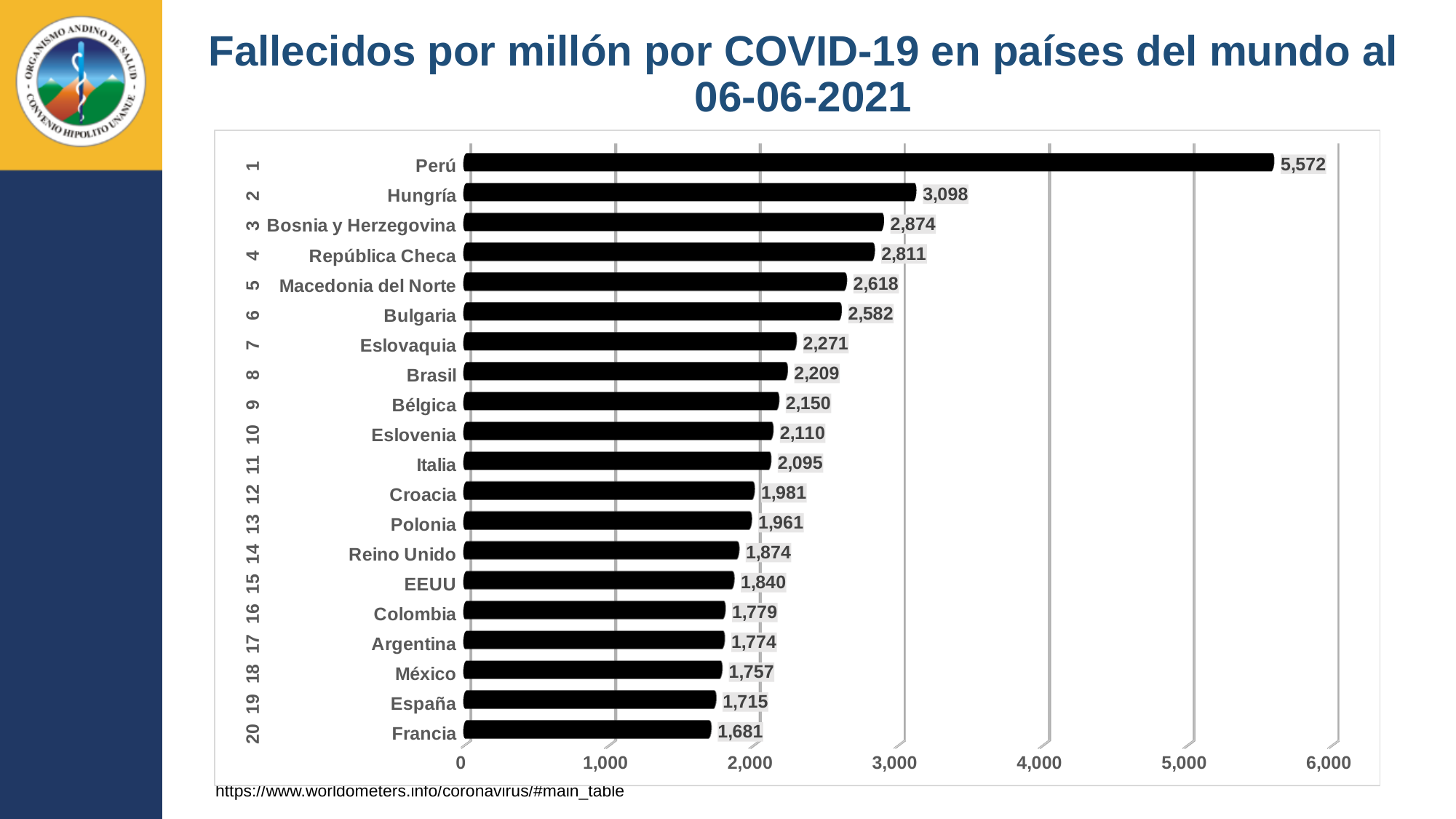
What is the value for Perú? 5,572 What is the value for Francia? 1,681 What is the title of the chart? Fallecidos por millón por COVID-19 en países del mundo al 06-06-2021 What kind of chart is shown on the slide? bar chart Which country has the lowest value? Francia How many countries are shown in the chart? 20 What is the value for Brasil? 2,209 Which has a larger value, Bulgaria or Eslovaquia? Bulgaria What is the difference between the values for Colombia and México? 22 Which country has the highest value? Perú Is the value for Reino Unido greater or less than 2,000? less What is the difference between the values for Perú and Hungría? 2,474